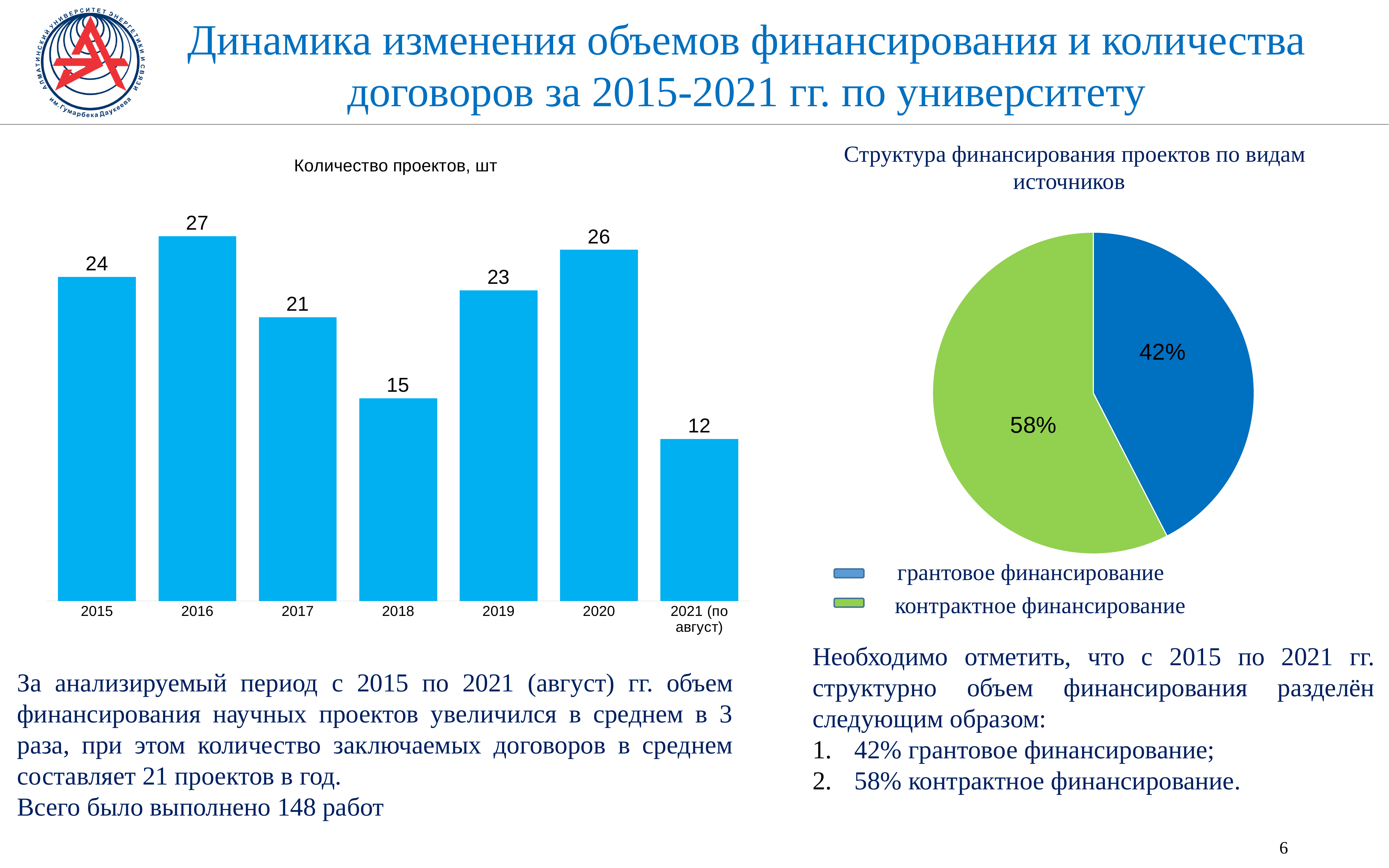
What kind of chart is the chart on the left titled 'Количество проектов, шт'? bar chart In the pie chart 'Структура финансирования проектов по видам источников', what share is грантовое финансирование? 42% In the bar chart 'Количество проектов, шт', does the value rise or fall from 2020 to 2021 (по август)? fall In the bar chart 'Количество проектов, шт', which year has the highest number of projects? 2016 In the pie chart 'Структура финансирования проектов по видам источников', how many entries does the legend list? 2 In the bar chart 'Количество проектов, шт', which is larger, the value for 2019 or the value for 2020? 2020 In the bar chart 'Количество проектов, шт', what is the difference between the values for 2016 and 2018? 12 In the bar chart 'Количество проектов, шт', what is the value for 2018? 15 In the bar chart 'Количество проектов, шт', which category has the lowest value? 2021 (по август) In the bar chart 'Количество проектов, шт', how many categories are shown on the x axis? 7 In the bar chart 'Количество проектов, шт', what is the value for 2016? 27 In the pie chart 'Структура финансирования проектов по видам источников', which slice is larger, грантовое финансирование or контрактное финансирование? контрактное финансирование